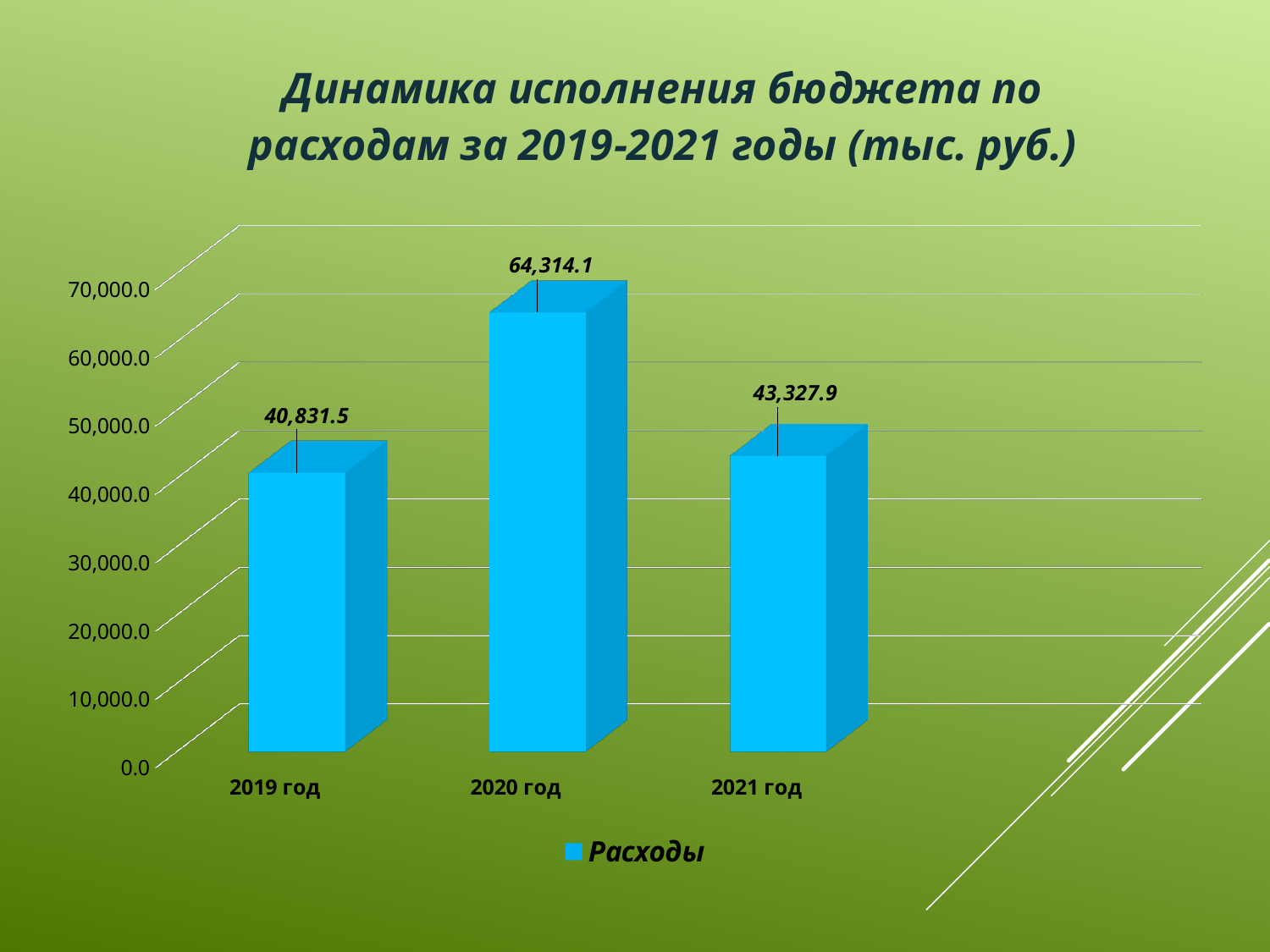
What kind of chart is this? bar chart What is the value for 2021 год? 43,327.9 What is the value for 2019 год? 40,831.5 Which year has the highest value? 2020 год How many years are shown on the x axis? 3 Is the value for 2020 год greater or less than 60,000.0? greater What is the difference between the values for 2020 год and 2019 год? 23,482.6 What is the value for 2020 год? 64,314.1 What is the difference between the values for 2021 год and 2019 год? 2,496.4 What series name does the legend show? Расходы Which is larger, the value for 2020 год or the value for 2021 год? 2020 год Which year has the lowest value? 2019 год